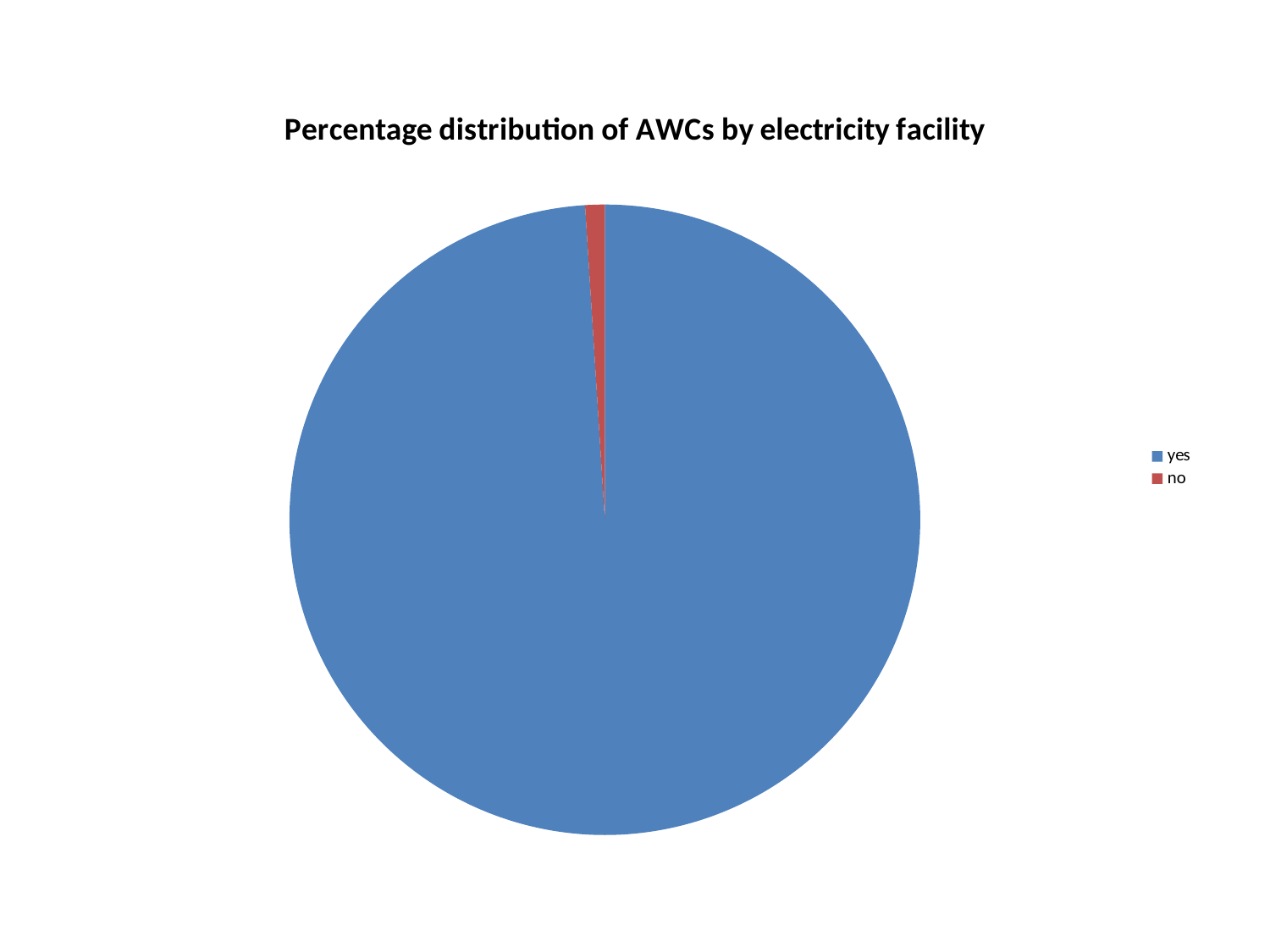
Which category has the smallest slice of the pie? no How many slices does the pie chart have? 2 Which slice is larger, "yes" or "no"? yes Is the share of the "no" slice greater or less than 10%? less How many entries does the legend list? 2 Which category has the largest slice of the pie? yes What colour is the "no" slice in the pie chart? red What is the title of the chart? Percentage distribution of AWCs by electricity facility Is the share of the "yes" slice greater or less than 50%? greater What kind of chart is shown on the slide? pie chart